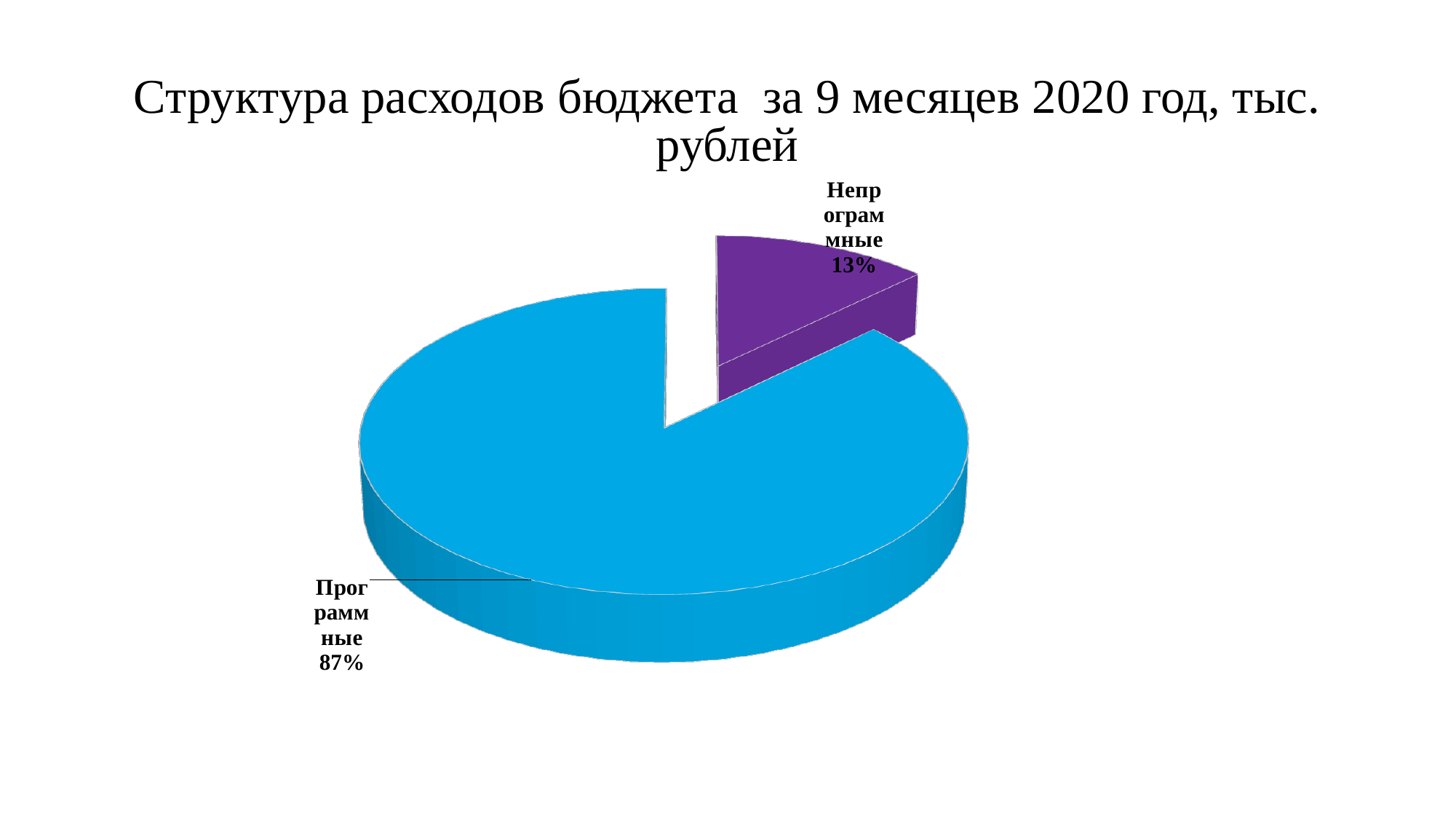
What colour is the Непрограммные slice? Purple What kind of chart is shown on the slide? Pie chart What is the difference in percentage points between the Программные and Непрограммные slices? 74 Which category has the largest slice of the pie? Программные What is the title of the chart on the slide? Структура расходов бюджета за 9 месяцев 2020 год, тыс. рублей How many slices does the pie chart have? 2 Which category has the smallest slice of the pie? Непрограммные Which slice is larger, Программные or Непрограммные? Программные What share of the pie does the Программные slice represent? 87% What share of the pie does the Непрограммные slice represent? 13%